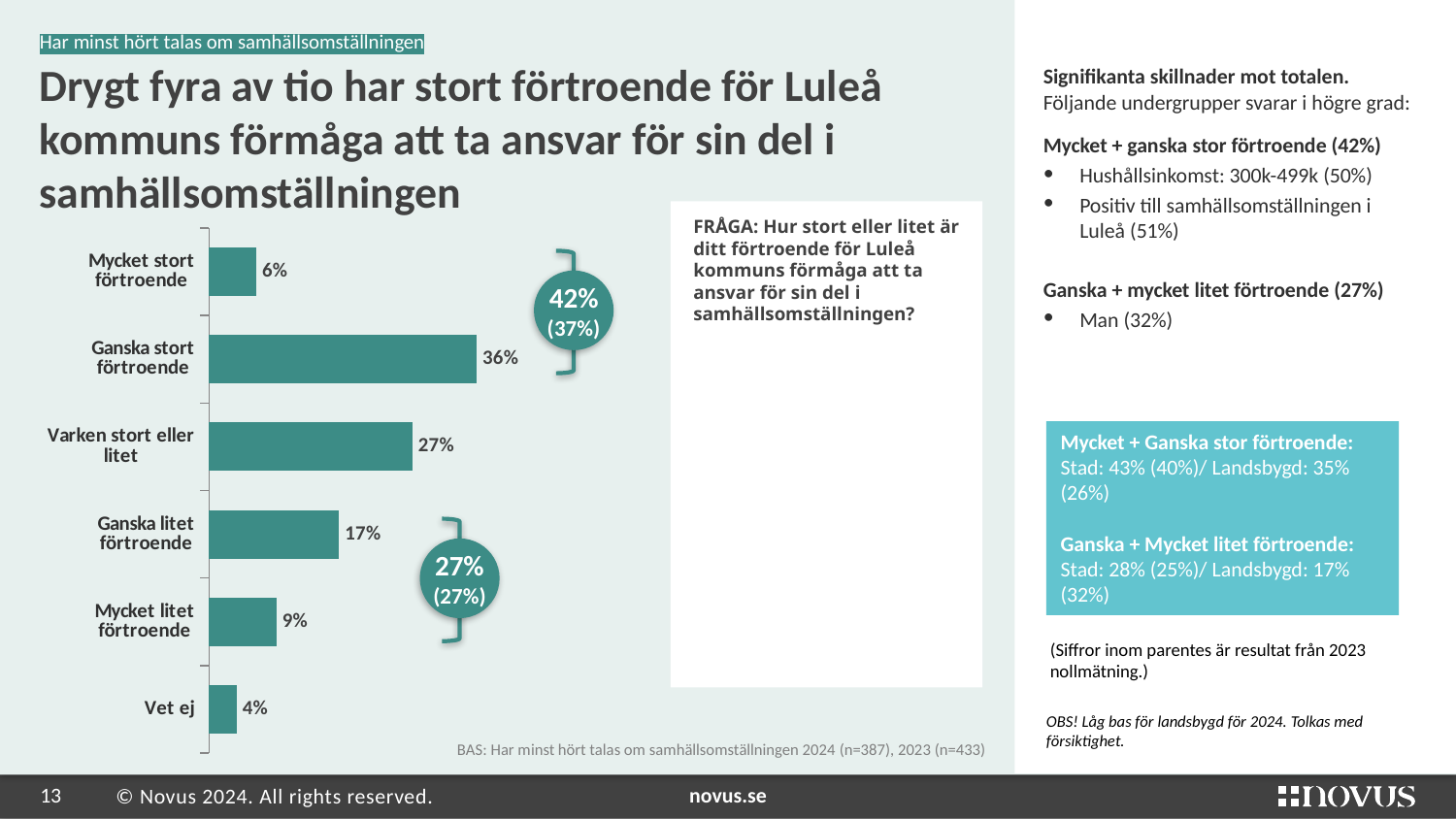
Which is larger: the value for "Varken stort eller litet" or the value for "Ganska litet förtroende"? Varken stort eller litet What percentage answered "Vet ej"? 4% Which response category has the lowest percentage? Vet ej How many response categories are shown in the bar chart? 6 What is the value shown for "Mycket litet förtroende"? 9% What is the combined share for "Mycket stort förtroende" and "Ganska stort förtroende" shown by the bracket label? 42% Which response category has the highest percentage? Ganska stort förtroende What type of chart is used on the slide? Bar chart What combined share is shown by the bracket label for "Ganska litet förtroende" and "Mycket litet förtroende"? 27% According to the bracket label, what was the 2023 result for the combined "Mycket + Ganska stort förtroende" share? 37% What percentage of respondents answered "Ganska stort förtroende"? 36% What is the difference in percentage points between "Ganska stort förtroende" and "Ganska litet förtroende"? 19